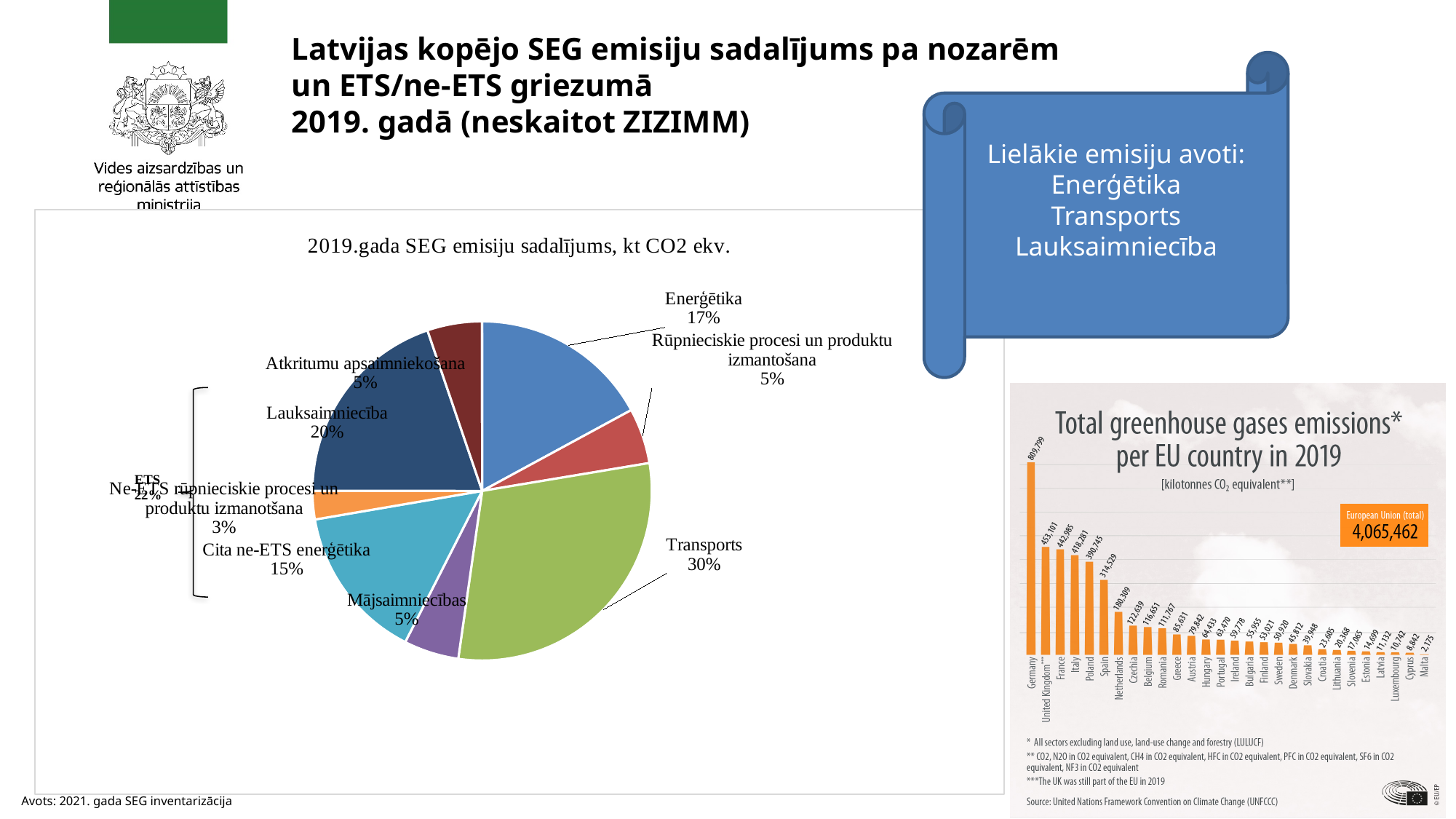
In the pie chart '2019.gada SEG emisiju sadalījums, kt CO2 ekv.', what share does Lauksaimniecība have? 20% In the pie chart '2019.gada SEG emisiju sadalījums, kt CO2 ekv.', which category has the largest share? Transports In the chart 'Total greenhouse gases emissions per EU country in 2019', which country has the highest value? Germany In the pie chart '2019.gada SEG emisiju sadalījums, kt CO2 ekv.', which category has the smallest share? Ne-ETS rūpnieciskie procesi un produktu izmanotšana How many slices does the pie chart '2019.gada SEG emisiju sadalījums, kt CO2 ekv.' have? 8 What type of chart is '2019.gada SEG emisiju sadalījums, kt CO2 ekv.'? pie chart In the pie chart '2019.gada SEG emisiju sadalījums, kt CO2 ekv.', how many percentage points larger is Transports than Enerģētika? 13 In the chart 'Total greenhouse gases emissions per EU country in 2019', what is the value for Latvia? 11,132 In the pie chart '2019.gada SEG emisiju sadalījums, kt CO2 ekv.', what share does Transports have? 30% In the pie chart '2019.gada SEG emisiju sadalījums, kt CO2 ekv.', which is larger: Lauksaimniecība or Cita ne-ETS enerģētika? Lauksaimniecība What type of chart is 'Total greenhouse gases emissions per EU country in 2019'? bar chart In the chart 'Total greenhouse gases emissions per EU country in 2019', which country has the lowest value? Malta